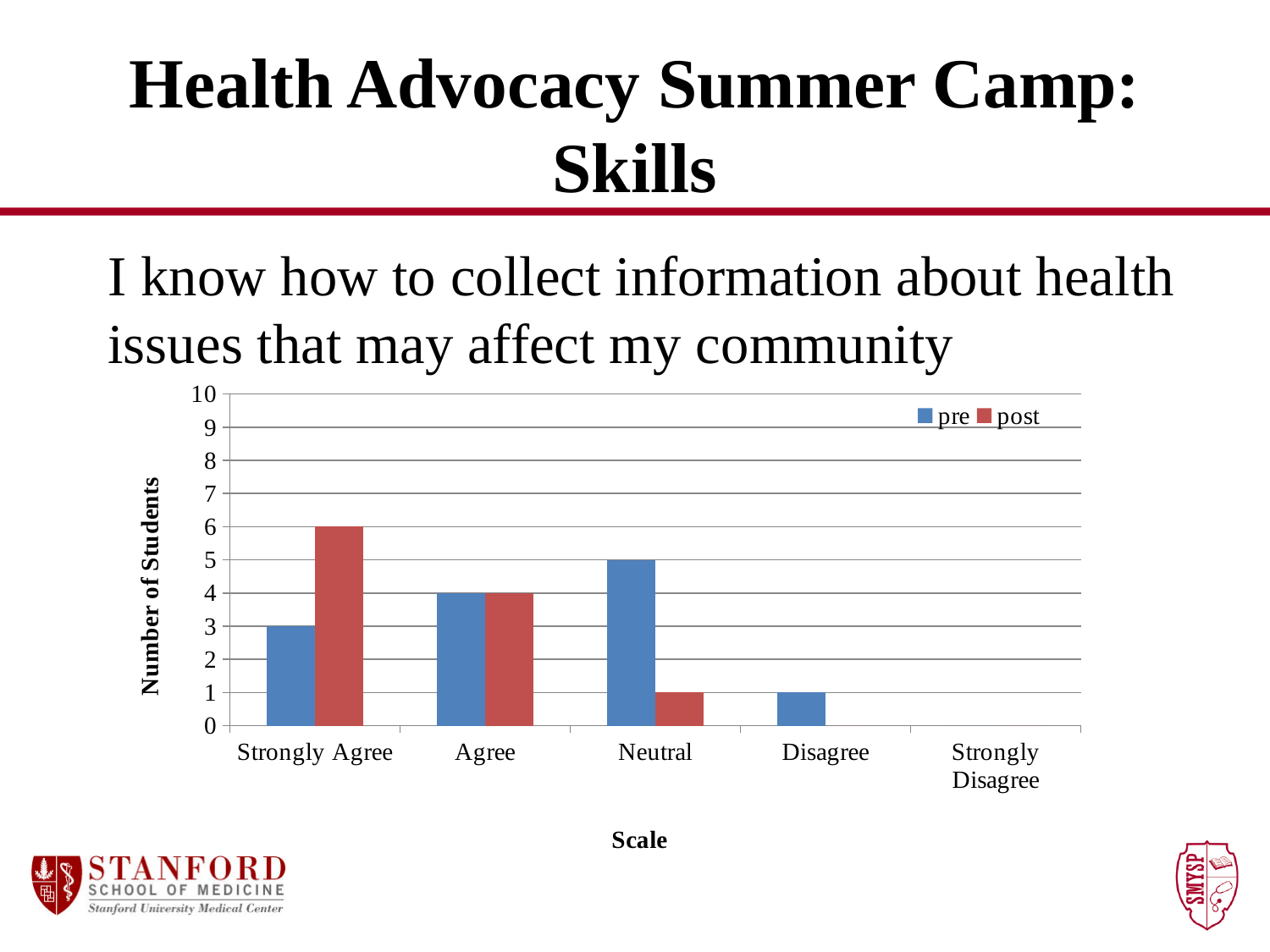
What is the pre value for Strongly Agree? 3 How many categories are shown on the x axis? 5 What is the post value for Strongly Agree? 6 Which is larger, the pre value for Neutral or the post value for Neutral? pre What kind of chart is shown on the slide? bar chart What is the pre value for Neutral? 5 Which category has the highest post value? Strongly Agree How many series does the legend list? 2 What is the post value for Neutral? 1 What is the label of the y axis? Number of Students Which category has the highest pre value? Neutral What is the difference between the post and pre values for Strongly Agree? 3